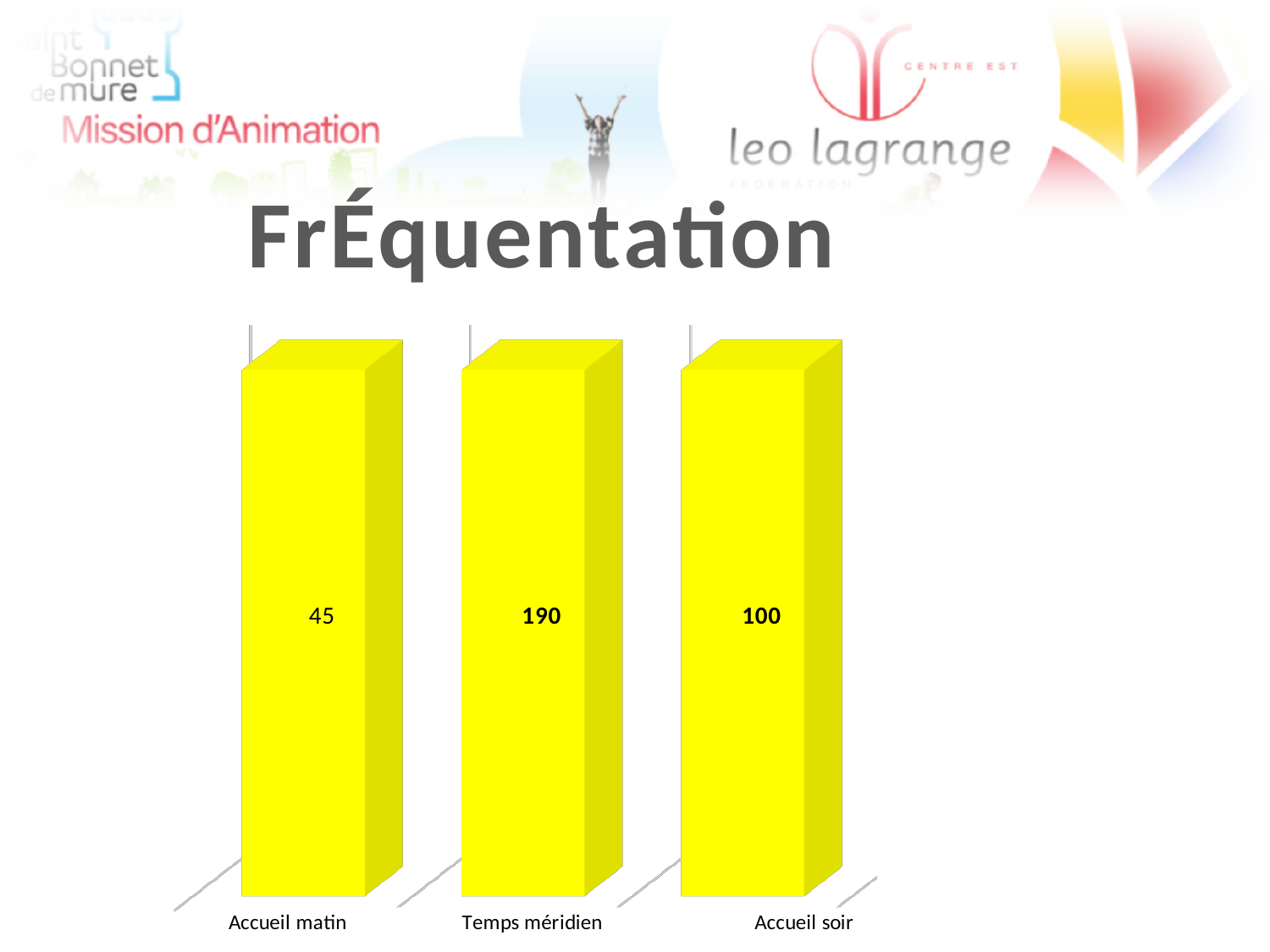
How many categories are shown in the chart? 3 What is the value for Accueil soir? 100 What is the title of the slide containing the chart? FrÉquentation Which category has the highest value? Temps méridien What is the value for Accueil matin? 45 What colour are the bars in the chart? Yellow What is the difference between the values for Temps méridien and Accueil soir? 90 Which category has the lowest value? Accueil matin What kind of chart is shown on the slide? Bar chart What is the difference between the values for Accueil soir and Accueil matin? 55 What is the value for Temps méridien? 190 Which is larger, the value for Accueil soir or the value for Accueil matin? Accueil soir